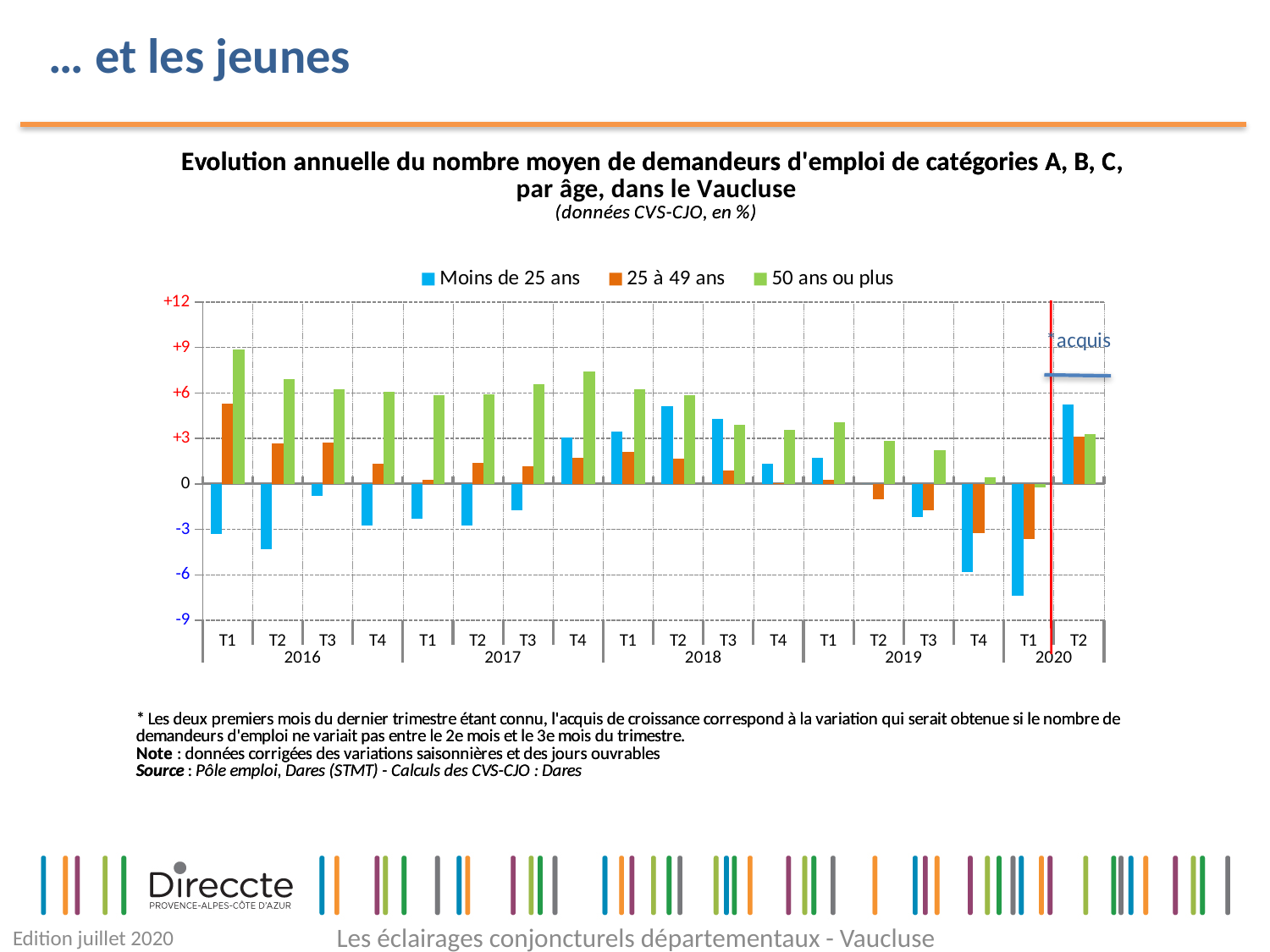
Is the value for Moins de 25 ans in T1 2020 greater or less than -6? less How many quarters are shown along the x axis? 18 Is the value for 25 à 49 ans in T1 2016 greater or less than +3? greater Does the 50 ans ou plus series generally rise or fall from T1 2016 to T1 2020? fall How many series does the legend list? 3 In T1 2018, which of the three series has the highest value? 50 ans ou plus In which quarter does the Moins de 25 ans series reach its lowest value? T1 2020 What colour represents the Moins de 25 ans series? blue In T2 2020, which is larger: the value for Moins de 25 ans or for 25 à 49 ans? Moins de 25 ans In which quarter does the 50 ans ou plus series reach its highest value? T1 2016 What kind of chart is shown on the slide? bar chart Is the value for 50 ans ou plus in T1 2016 greater or less than +6? greater